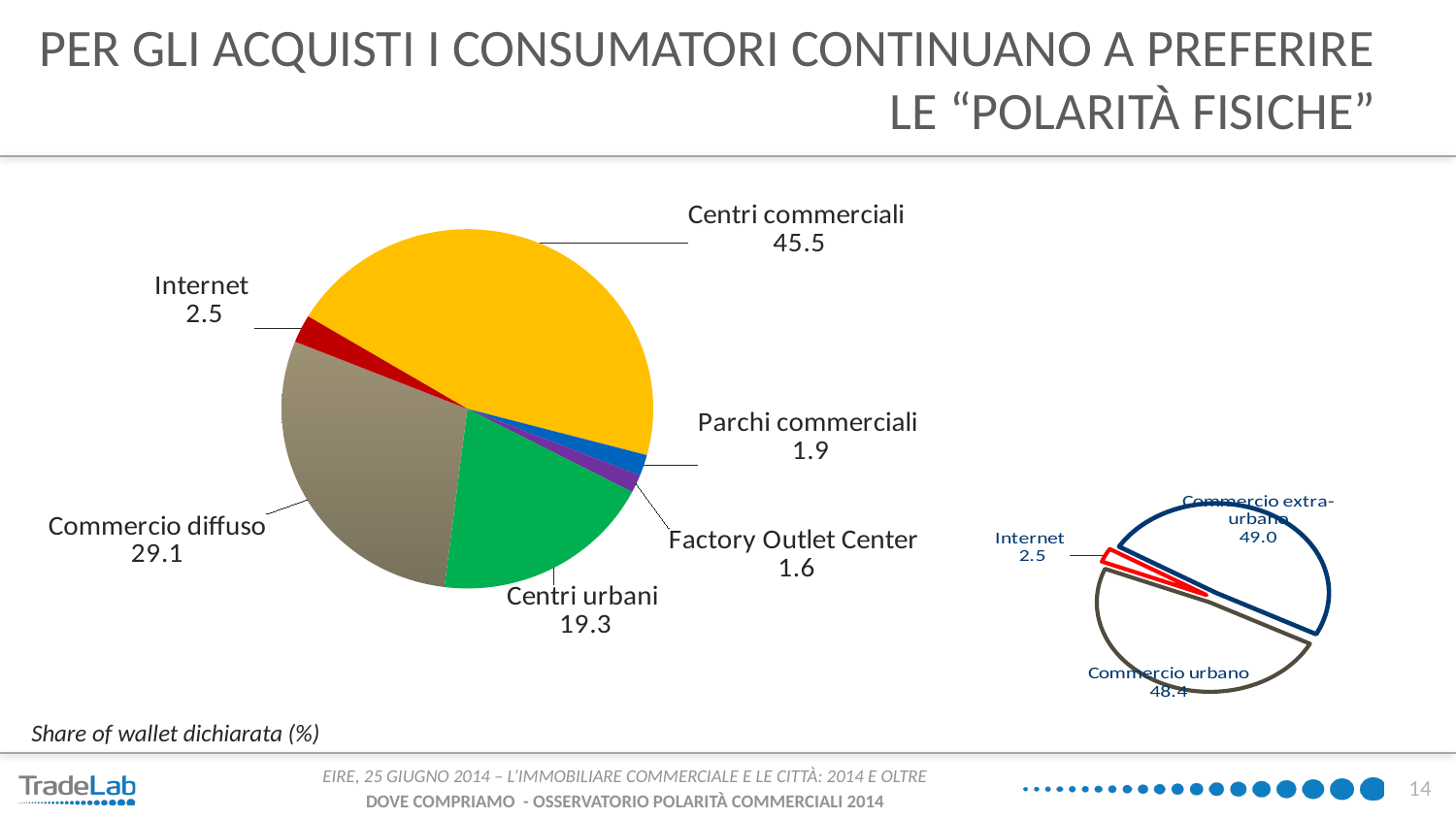
How many slices does the large pie chart on the left have? 6 In the large pie chart on the left, what is the value for Commercio diffuso? 29.1 In the small pie chart on the right, what is the value for Commercio extra-urbano? 49.0 In the large pie chart on the left, what is the difference between the values for Centri commerciali and Commercio diffuso? 16.4 In the large pie chart on the left, which category has the largest slice? Centri commerciali In the small pie chart on the right, what is the value for Commercio urbano? 48.4 How many slices does the small pie chart on the right have? 3 In the large pie chart on the left, what is the value for Centri commerciali? 45.5 In the large pie chart on the left, what is the value for Centri urbani? 19.3 What type of chart is the large chart on the left? Pie chart In the large pie chart on the left, which is larger, Parchi commerciali or Factory Outlet Center? Parchi commerciali In the large pie chart on the left, which category has the smallest slice? Factory Outlet Center